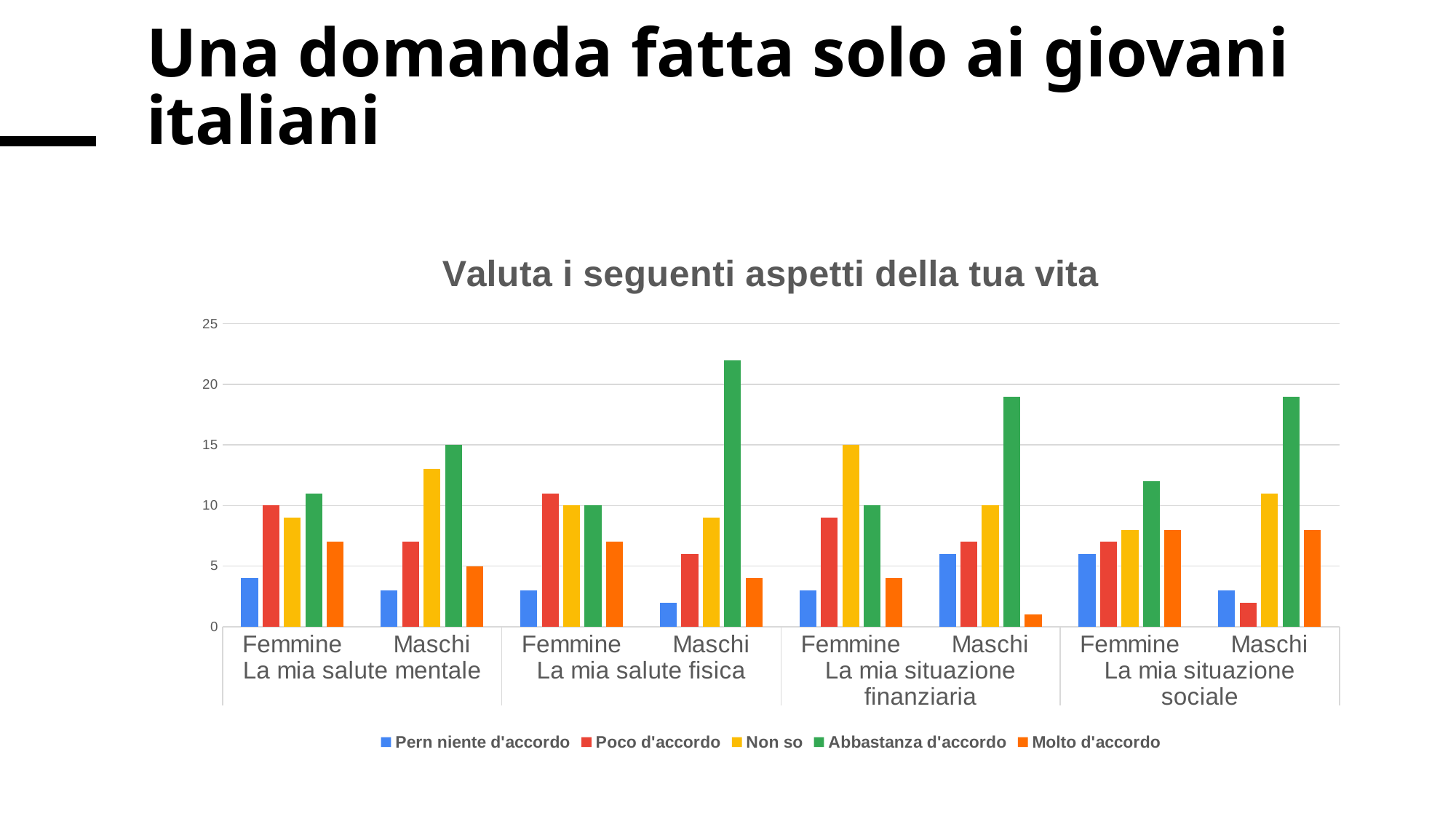
Which bar is the lowest in the whole chart? Molto d'accordo for Maschi, La mia situazione finanziaria Which bar is the highest in the whole chart? Abbastanza d'accordo for Maschi, La mia salute fisica For Femmine in La mia situazione sociale, which is larger: Pern niente d'accordo or Abbastanza d'accordo? Abbastanza d'accordo How many series does the legend list? 5 What type of chart is shown on the slide? bar chart How many aspects of life (category groups) are shown on the x axis? 4 For Maschi in La mia salute mentale, which is larger: Non so or Abbastanza d'accordo? Abbastanza d'accordo Is the value of Abbastanza d'accordo for Maschi in La mia salute fisica greater or less than 20? greater Is the value of Molto d'accordo for Maschi in La mia situazione finanziaria greater or less than 5? less What is the title of the chart? Valuta i seguenti aspetti della tua vita Is the value of Non so for Femmine in La mia situazione finanziaria greater or less than 10? greater Which series is shown in green in the legend? Abbastanza d'accordo